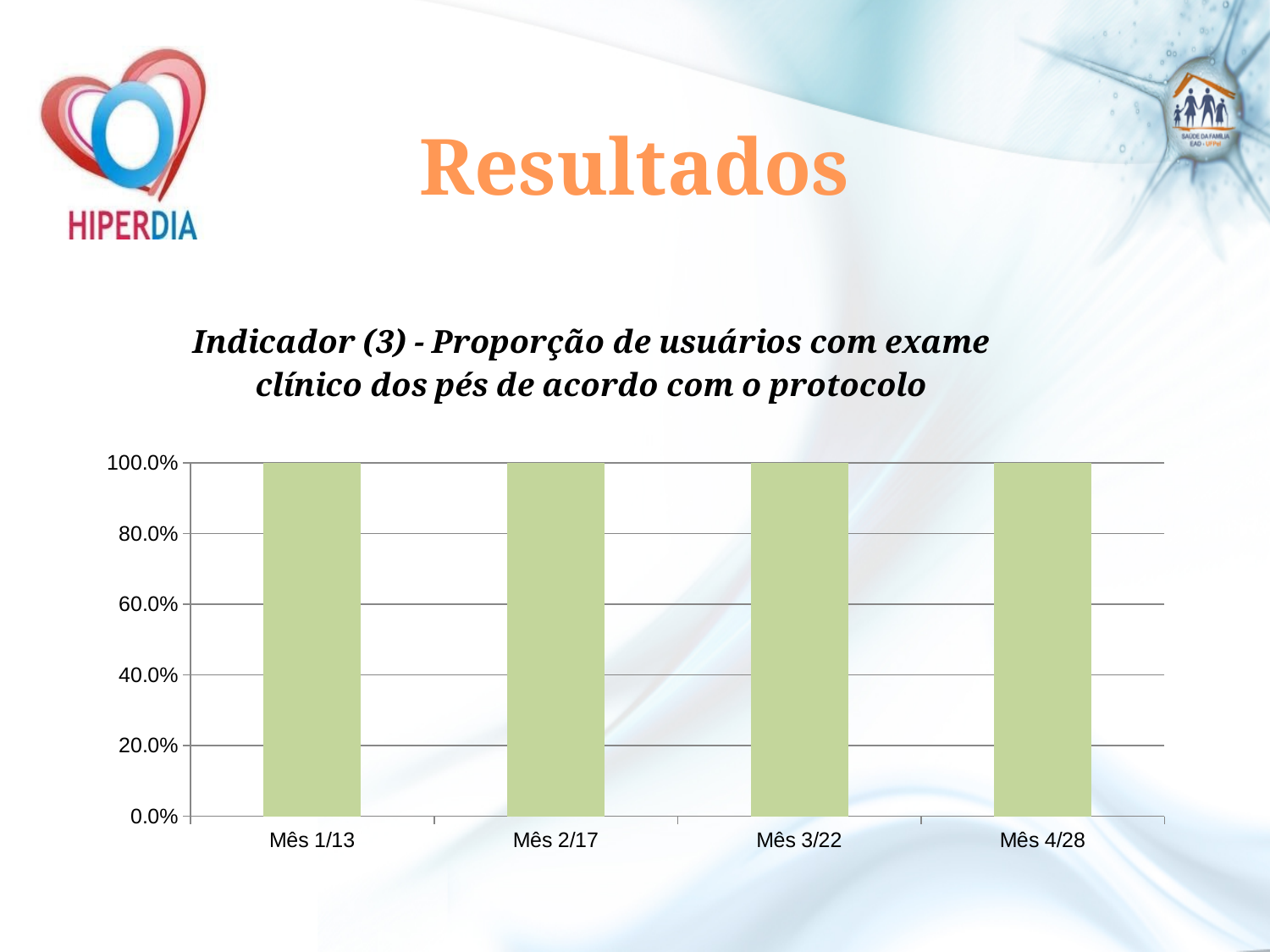
Is the value for Mês 3/22 greater or less than 80.0%? greater Is the value for Mês 1/13 greater or less than 60.0%? greater What kind of chart is shown on the slide? bar chart What is the value for Mês 4/28? 100.0% What is the title of the chart? Indicador (3) - Proporção de usuários com exame clínico dos pés de acordo com o protocolo How many categories are shown on the x axis? 4 What is the difference between the values for Mês 2/17 and Mês 4/28? 0.0% What is the value for Mês 2/17? 100.0% What is the value for Mês 3/22? 100.0% Do the values rise, fall or stay the same from Mês 1/13 to Mês 4/28? stay the same What colour are the bars in the chart? light green What is the value for Mês 1/13? 100.0%